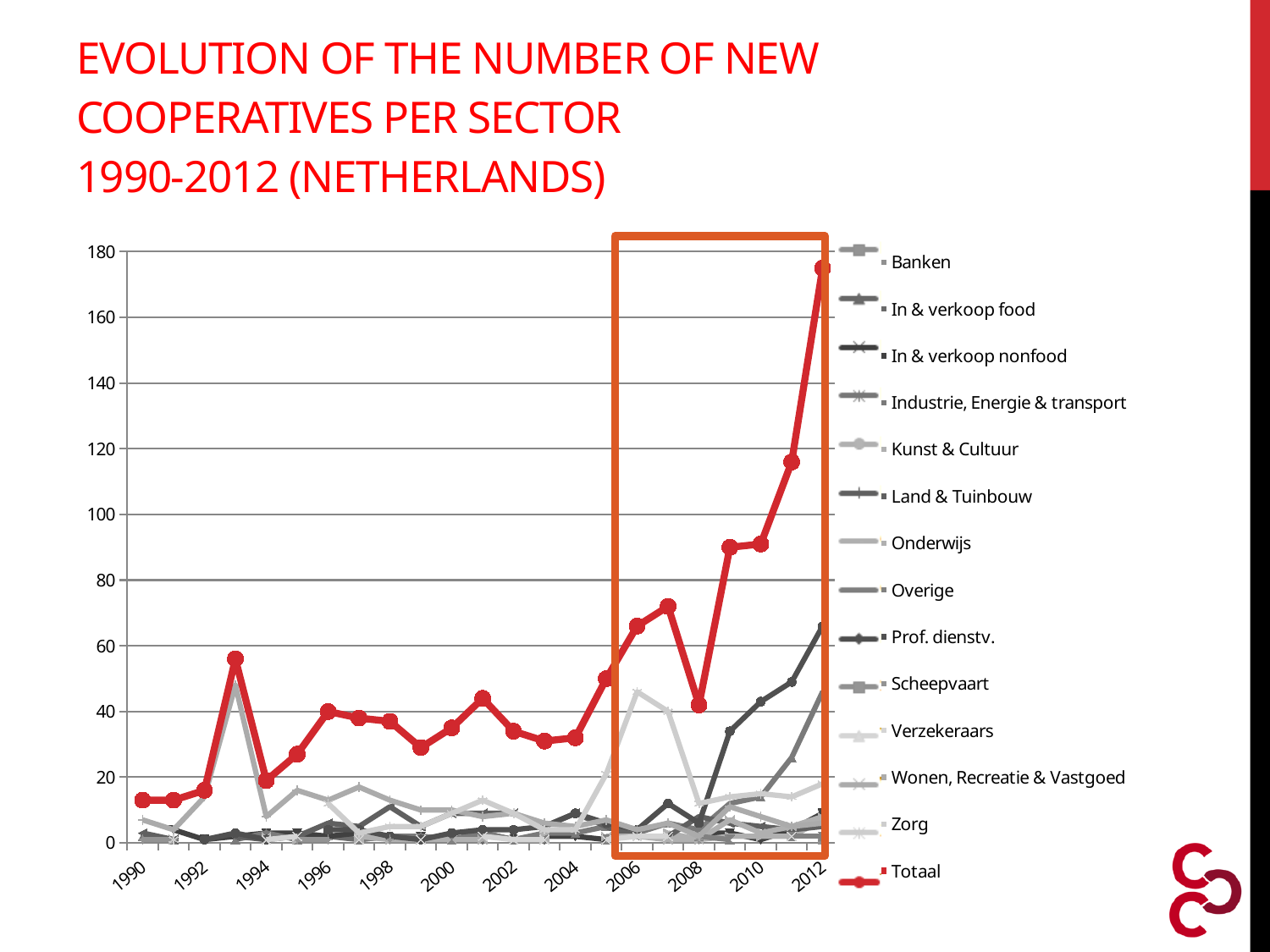
Which is larger, the Totaal value in 2012 or the Totaal value in 2006? 2012 Does the Totaal series rise or fall between 2008 and 2012? rise How many series does the legend list? 14 Is the value of Totaal in 2010 greater or less than 80? greater Is the value of Totaal in 2012 greater or less than 160? greater What kind of chart is shown on the slide? line chart In which year does the Totaal series reach its highest value? 2012 Which years are enclosed by the orange highlight box on the chart? 2006 to 2012 How many years (data points) are plotted along the x axis, from 1990 to 2012? 23 Which series is drawn in red on the chart? Totaal Is the value of Totaal in 1990 greater or less than 20? less